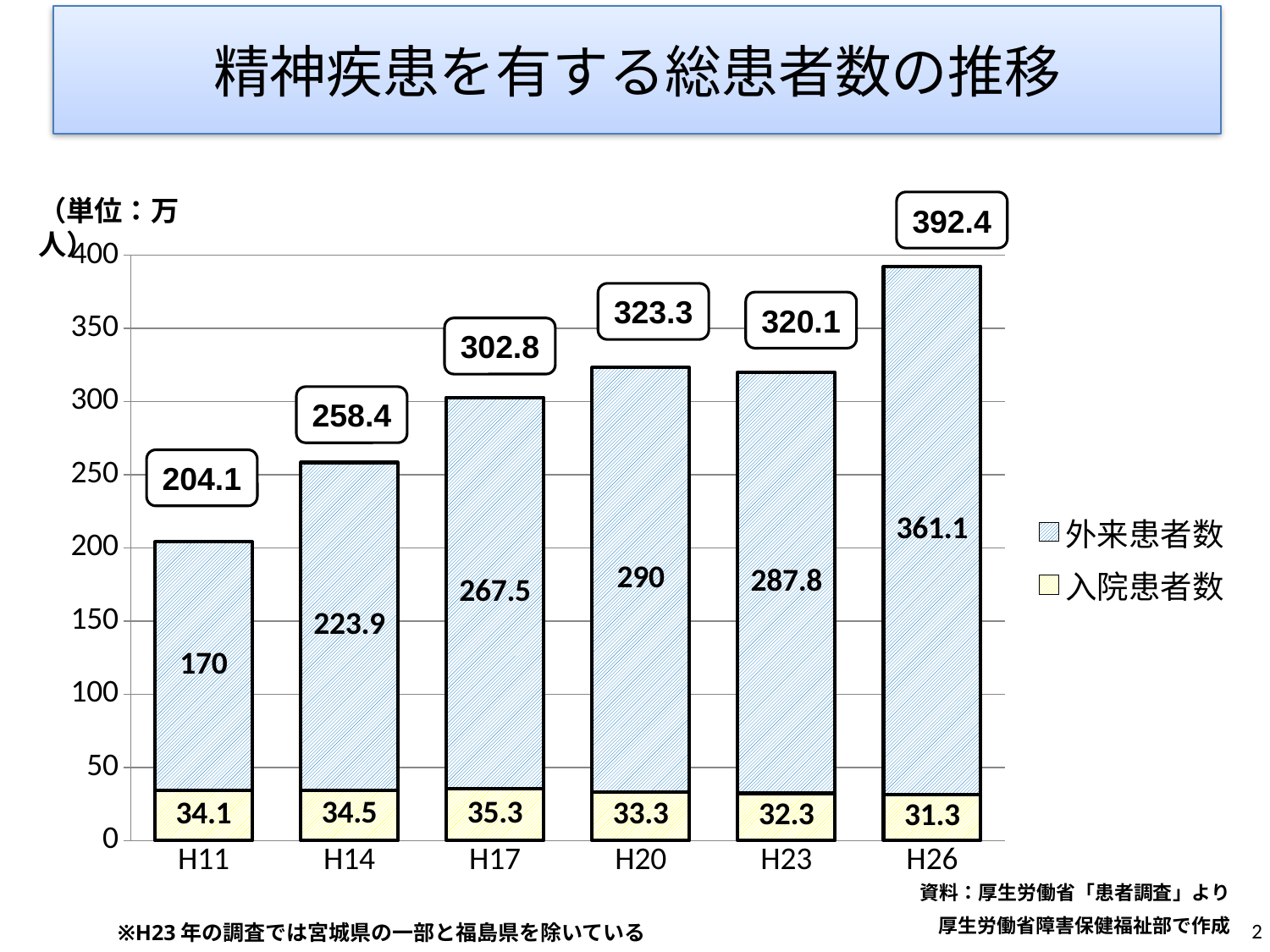
How many years are shown on the x axis? 6 Is the total for H14 greater or less than 250? greater What is the total labelled above the H20 bar? 323.3 What is the value for 外来患者数 in H17? 267.5 What kind of chart is shown on the slide? stacked bar chart Which is larger, the total for H20 or the total for H23? H20 Which year has the lowest value for 入院患者数? H26 What is the difference between the 外来患者数 values for H26 and H11? 191.1 What unit is indicated for the values on the chart? 万人 What is the value for 入院患者数 in H26? 31.3 Which year has the highest total number of patients? H26 How many series does the legend list? 2